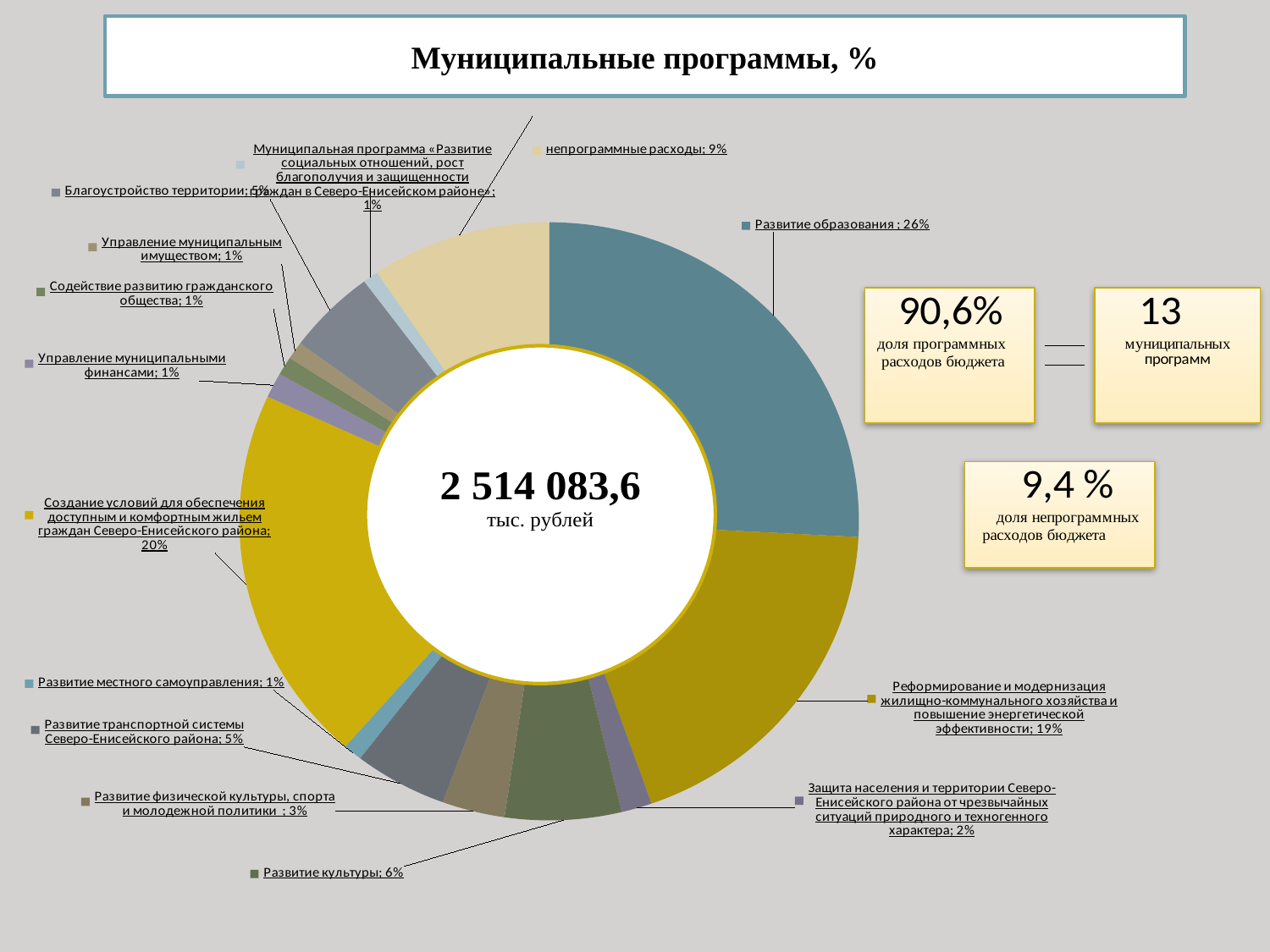
What is the value shown for "Защита населения и территории Северо-Енисейского района от чрезвычайных ситуаций природного и техногенного характера"? 2% What is the difference between the shares of "Развитие образования" and "Создание условий для обеспечения доступным и комфортным жильем граждан Северо-Енисейского района"? 6% Which category has the largest slice of the pie? Развитие образования What kind of chart is shown on the slide? doughnut chart What share of the pie does "Реформирование и модернизация жилищно-коммунального хозяйства и повышение энергетической эффективности" have? 19% Which is larger: the share for "Развитие транспортной системы Северо-Енисейского района" or the share for "Развитие физической культуры, спорта и молодежной политики"? Развитие транспортной системы Северо-Енисейского района What is the value shown for "Развитие культуры"? 6% What is the value shown for "непрограммные расходы"? 9% What is the title of the chart? Муниципальные программы, % What total amount is printed in the centre of the pie chart? 2 514 083,6 тыс. рублей How many slices does the pie chart have? 14 What share of the pie does "Развитие образования" have? 26%